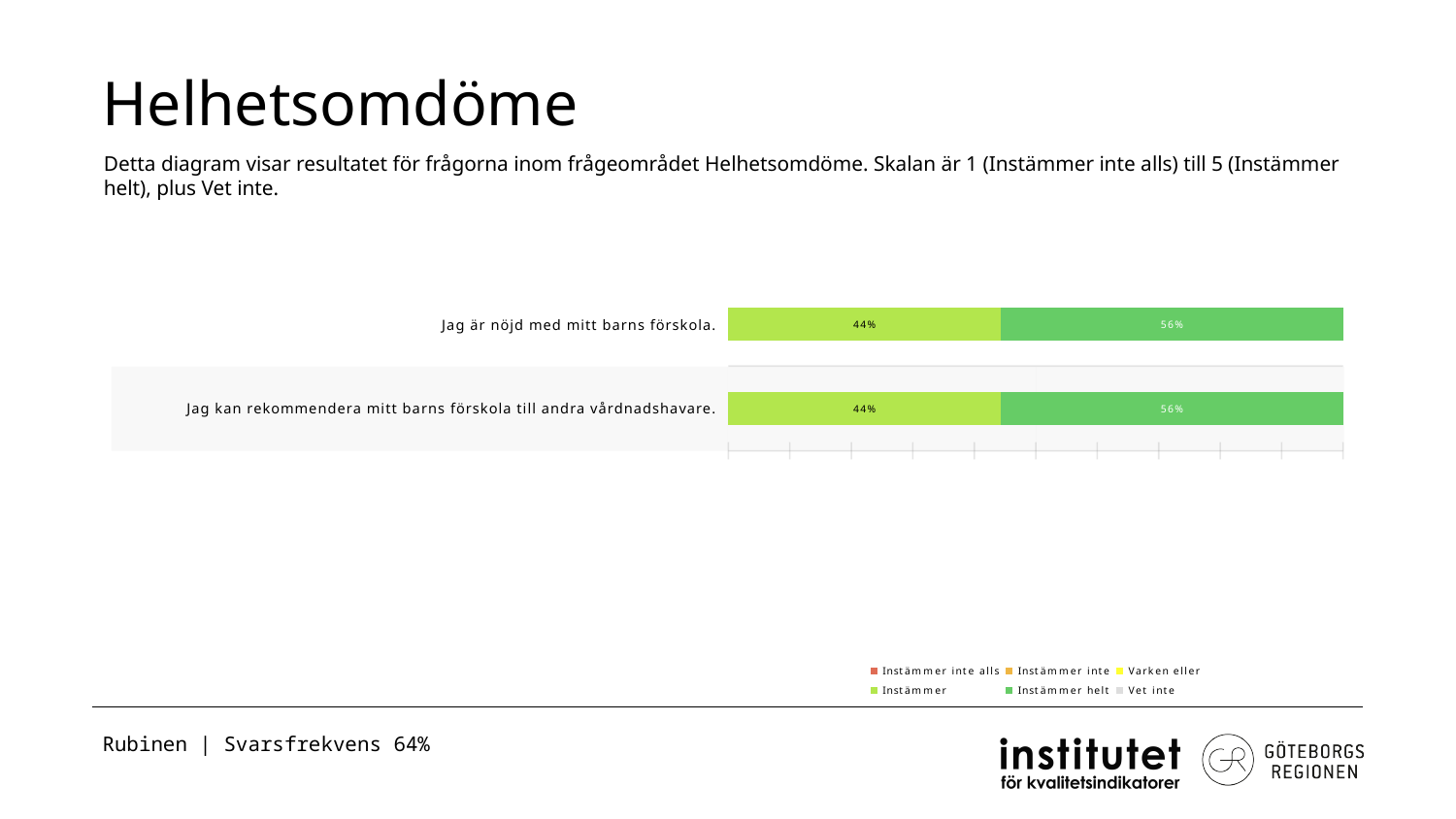
What is the total of the labelled segments in the bar for 'Jag är nöjd med mitt barns förskola.'? 100% What is the value of the 'Instämmer helt' segment for 'Jag är nöjd med mitt barns förskola.'? 56% What is the value of the 'Instämmer helt' segment for 'Jag kan rekommendera mitt barns förskola till andra vårdnadshavare.'? 56% What is the value of the 'Instämmer' segment for 'Jag kan rekommendera mitt barns förskola till andra vårdnadshavare.'? 44% How many categories (statements) are plotted in the chart? 2 For 'Jag är nöjd med mitt barns förskola.', which segment is larger: 'Instämmer' or 'Instämmer helt'? Instämmer helt Which legend entry is shown in grey? Vet inte Which legend entry is shown in the darker green colour? Instämmer helt How many series does the legend list? 6 What is the value of the 'Instämmer' segment for 'Jag är nöjd med mitt barns förskola.'? 44% What kind of chart is shown on the slide? Stacked bar chart What is the difference between the 'Instämmer helt' and 'Instämmer' segments for 'Jag kan rekommendera mitt barns förskola till andra vårdnadshavare.'? 12%